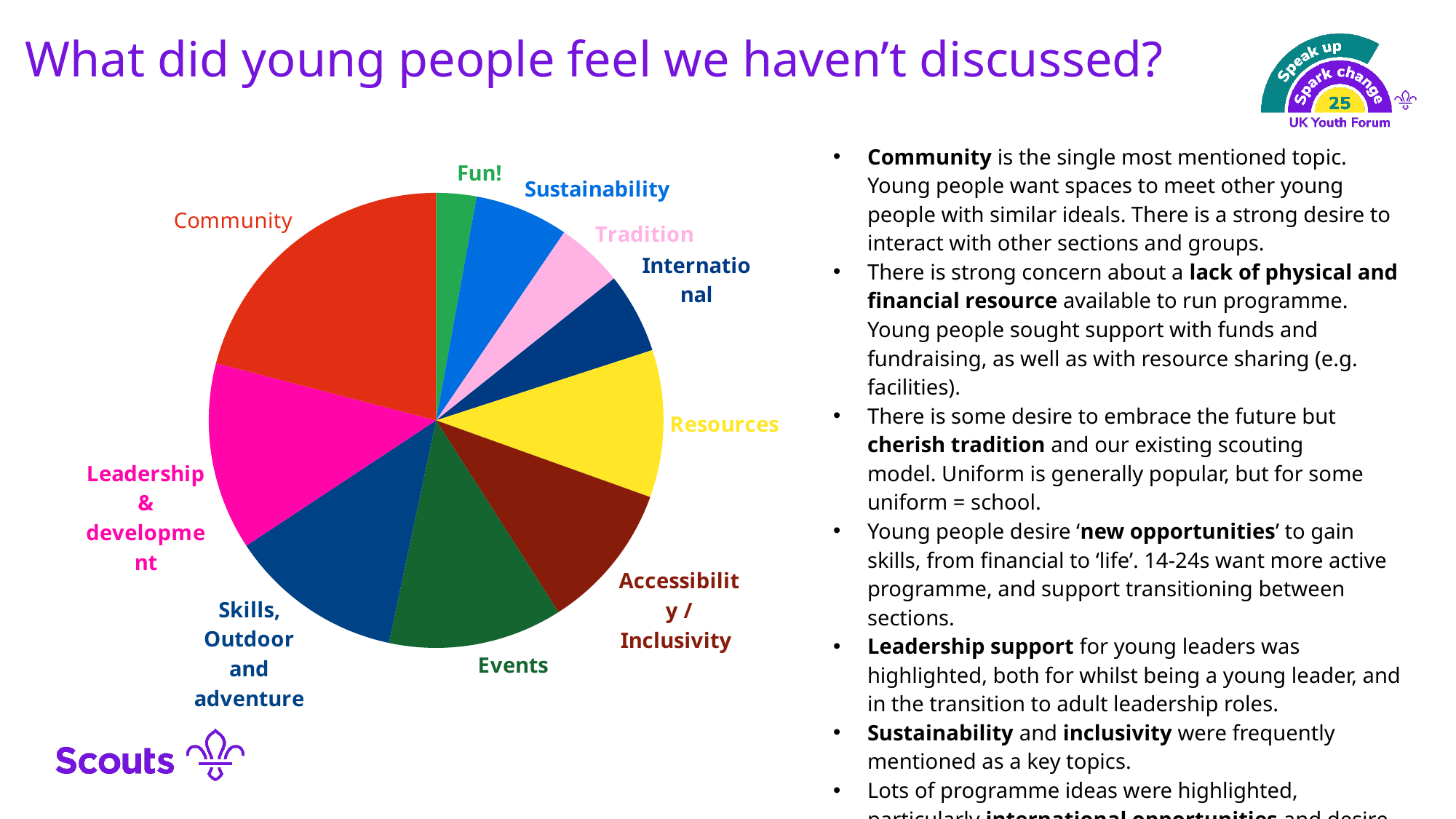
Which category has the smallest slice of the pie chart? Fun! Which slice is larger, Skills, Outdoor and adventure or Fun!? Skills, Outdoor and adventure Which category has the largest slice of the pie chart? Community Which slice is larger, Community or Fun!? Community What colour is the Resources slice of the pie chart? yellow What kind of chart is shown on the slide? pie chart How many slices does the pie chart have? 10 Which slice is larger, Resources or International? Resources What is the title of the slide containing the pie chart? What did young people feel we haven't discussed?